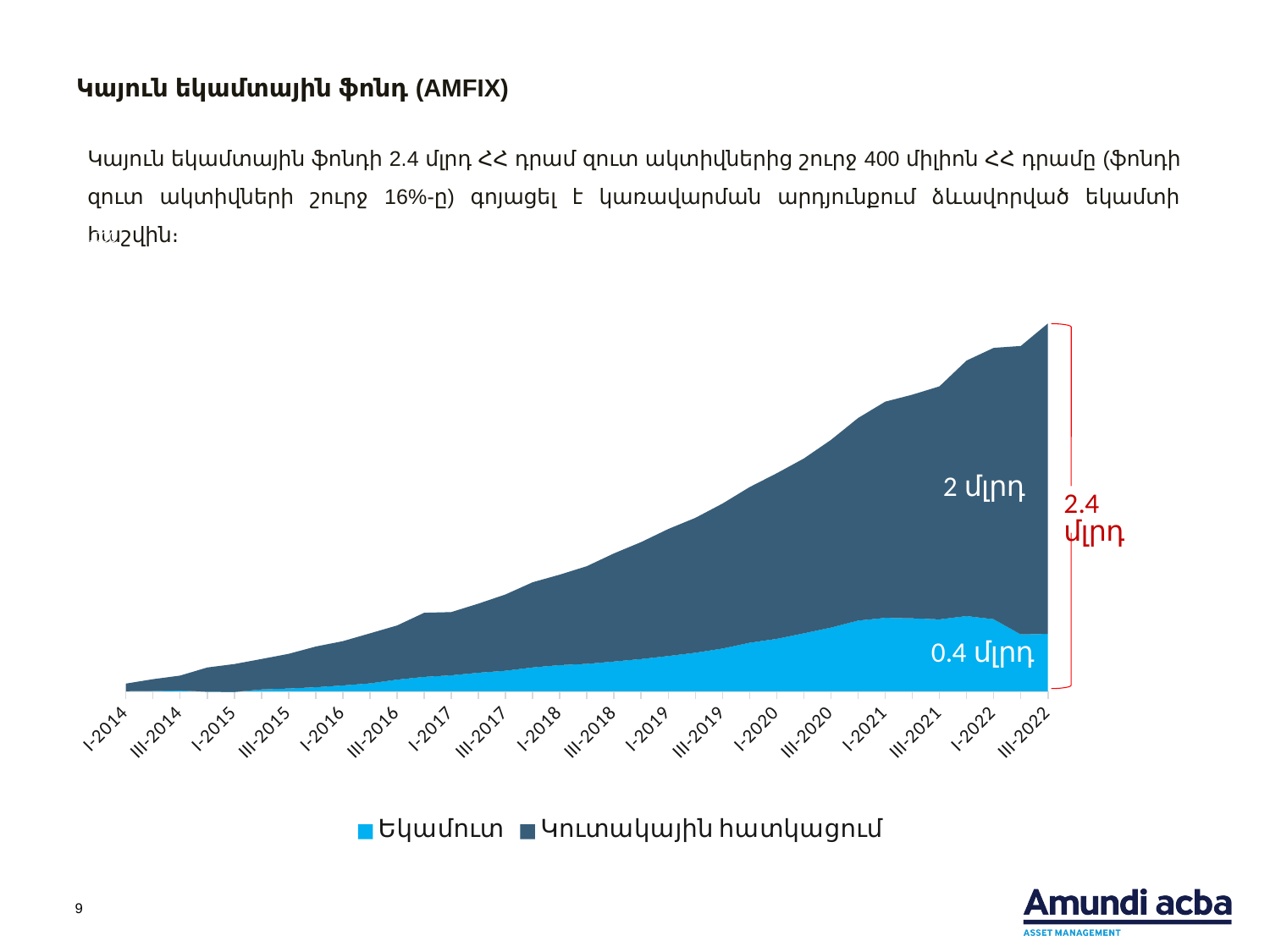
What is the total of the two series at III-2022, as labelled on the chart? 2.4 մլրդ Which series is shown in light blue? Եկամուտ What kind of chart is shown on the slide? Area chart How many series does the legend list? 2 What is the difference between the Կուտակային հատկացում value (2 մլրդ) and the Եկամուտ value (0.4 մլրդ) at III-2022? 1.6 մլրդ At III-2022, which series has the larger value, Եկամուտ or Կուտակային հատկացում? Կուտակային հատկացում What is the first period label on the x axis? I-2014 What are the two series named in the legend? Եկամուտ and Կուտակային հատկացում What is the labelled value of Եկամուտ at the end of the chart (III-2022)? 0.4 մլրդ What is the labelled value of Կուտակային հատկացում at the end of the chart (III-2022)? 2 մլրդ Do the total values rise or fall along the x axis from I-2014 to III-2022? Rise